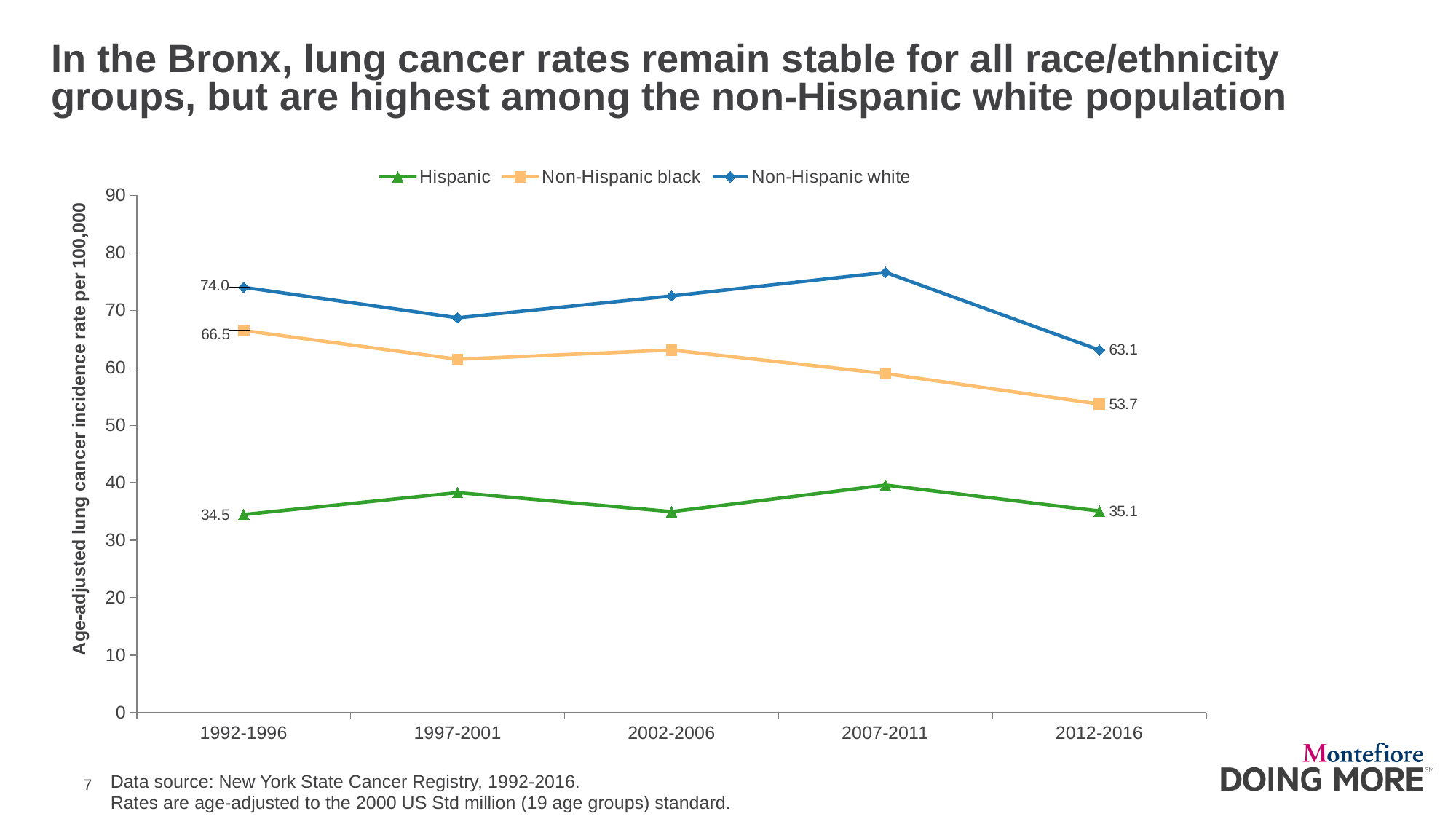
What is the lung cancer incidence rate for the Hispanic group in 1992-1996? 34.5 How many series does the legend list? 3 How many time periods are shown on the x axis? 5 By how much did the Non-Hispanic black rate change from 1992-1996 to 2012-2016? 12.8 Which group has the highest lung cancer incidence rate in 2012-2016? Non-Hispanic white What is the lung cancer incidence rate for the Non-Hispanic black group in 2012-2016? 53.7 What is the lung cancer incidence rate for the Non-Hispanic white group in 1992-1996? 74.0 Which group has the lowest lung cancer incidence rate in 1992-1996? Hispanic Is the Non-Hispanic white rate in 2007-2011 greater or less than 70? greater What is the lung cancer incidence rate for the Non-Hispanic white group in 2012-2016? 63.1 What is the difference between the Non-Hispanic white rate and the Non-Hispanic black rate in 1992-1996? 7.5